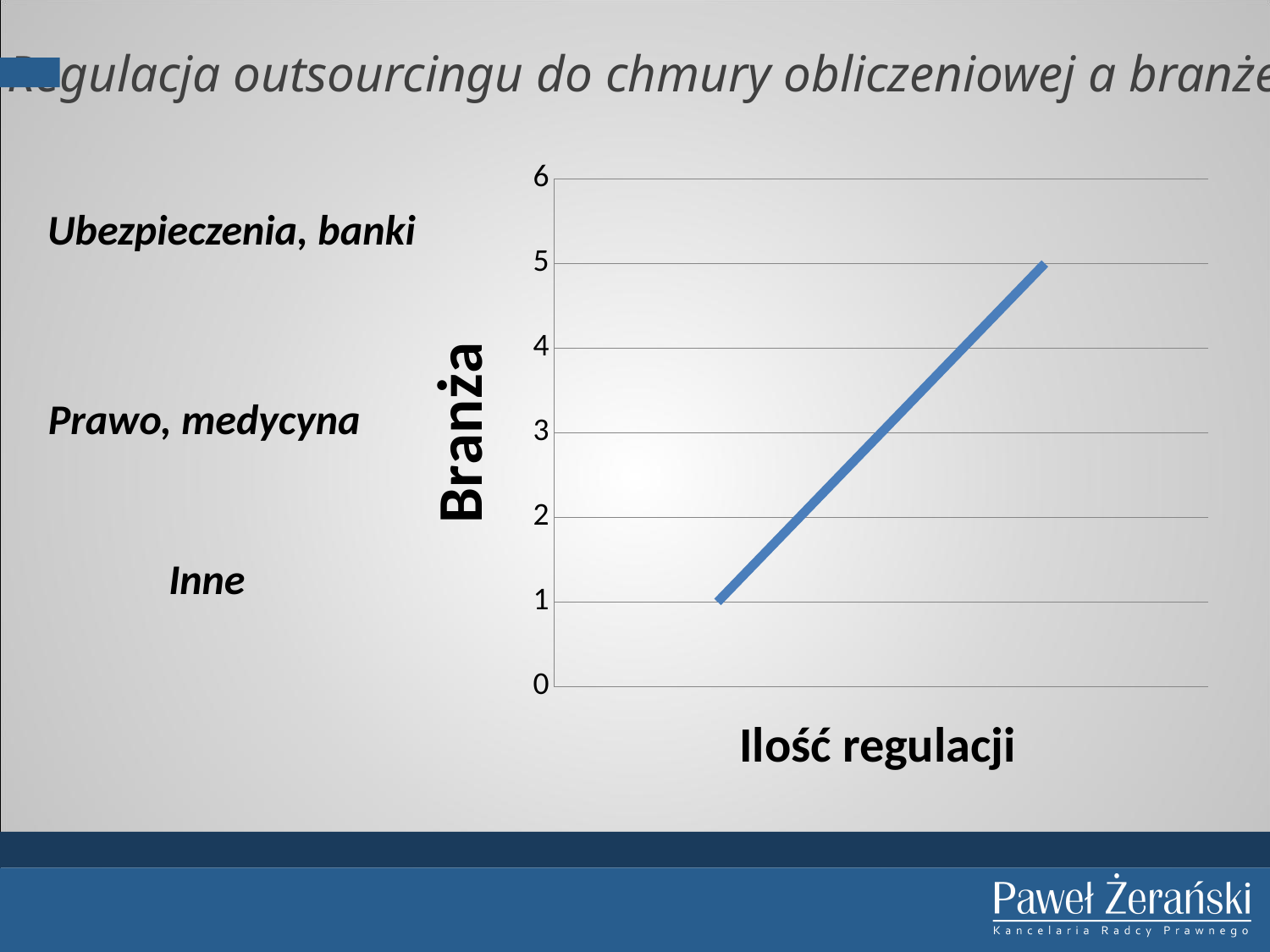
What is the highest tick value shown on the vertical axis? 6 What is the label of the horizontal axis? Ilość regulacji What is the label of the vertical axis? Branża Is the value at the left end of the line greater or less than 2? less Does the line rise or fall from left to right? rises Which end of the line has the higher value, the left or the right? right What value does the line start at on its left end? 1 What value does the line reach at its right end? 5 What kind of chart is shown on the slide? line chart What is the difference between the value at the right end of the line and the value at the left end? 4 Is the value at the right end of the line greater or less than 4? greater